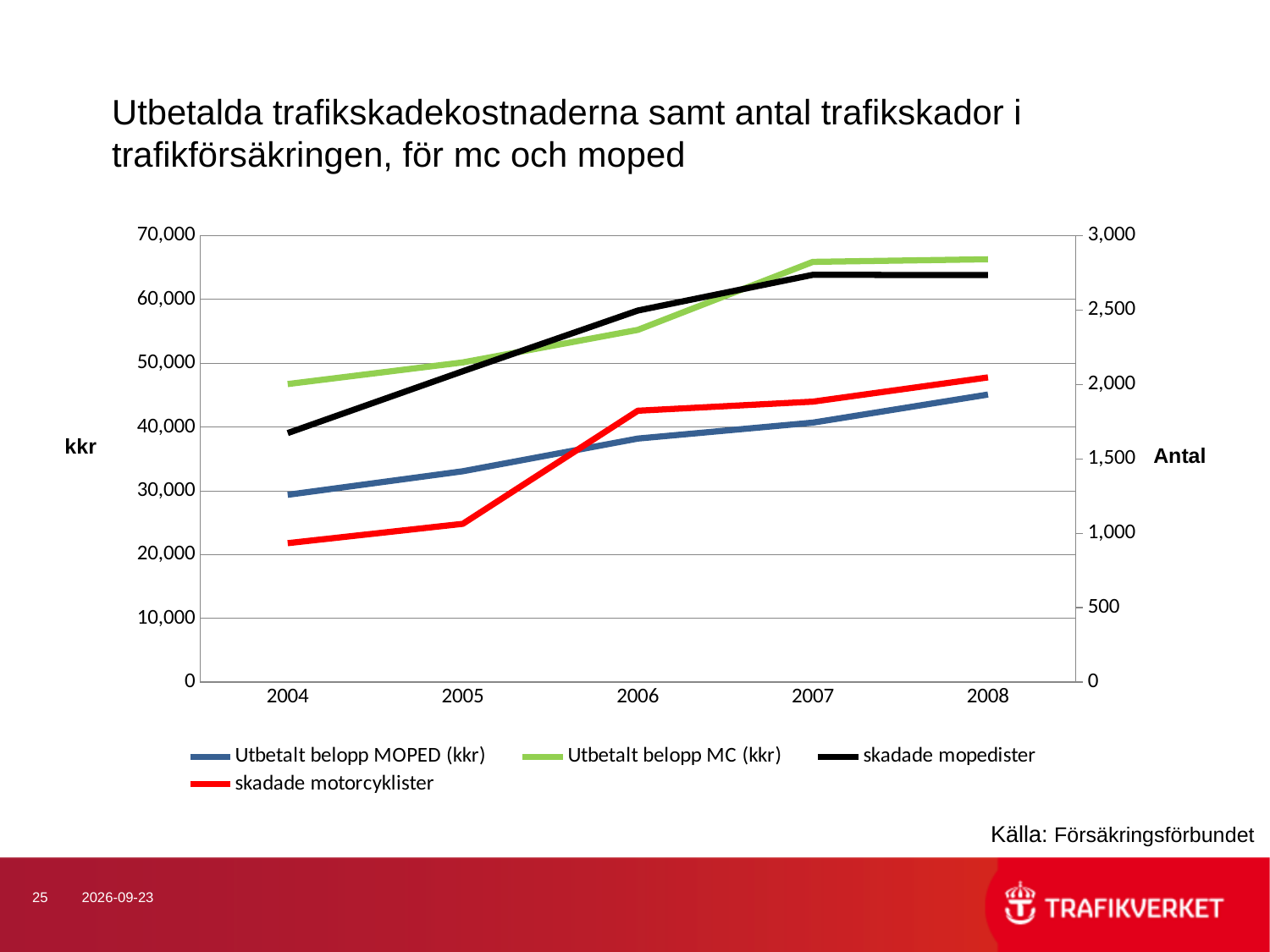
What is the label on the left vertical axis? kkr In which year is Utbetalt belopp MC (kkr) lowest? 2004 Is the value for Utbetalt belopp MC (kkr) in 2008 greater or less than 60,000? greater Is the value for Utbetalt belopp MOPED (kkr) in 2008 greater or less than 40,000? greater How many years are shown on the x axis? 5 Does the value for Utbetalt belopp MOPED (kkr) rise or fall from 2004 to 2008? rise Is the value for skadade mopedister in 2008 greater or less than 2,500? greater In 2008, which is larger: Utbetalt belopp MC (kkr) or Utbetalt belopp MOPED (kkr)? Utbetalt belopp MC (kkr) How many series does the legend list? 4 What is the label on the right vertical axis? Antal What kind of chart is shown on the slide? line chart